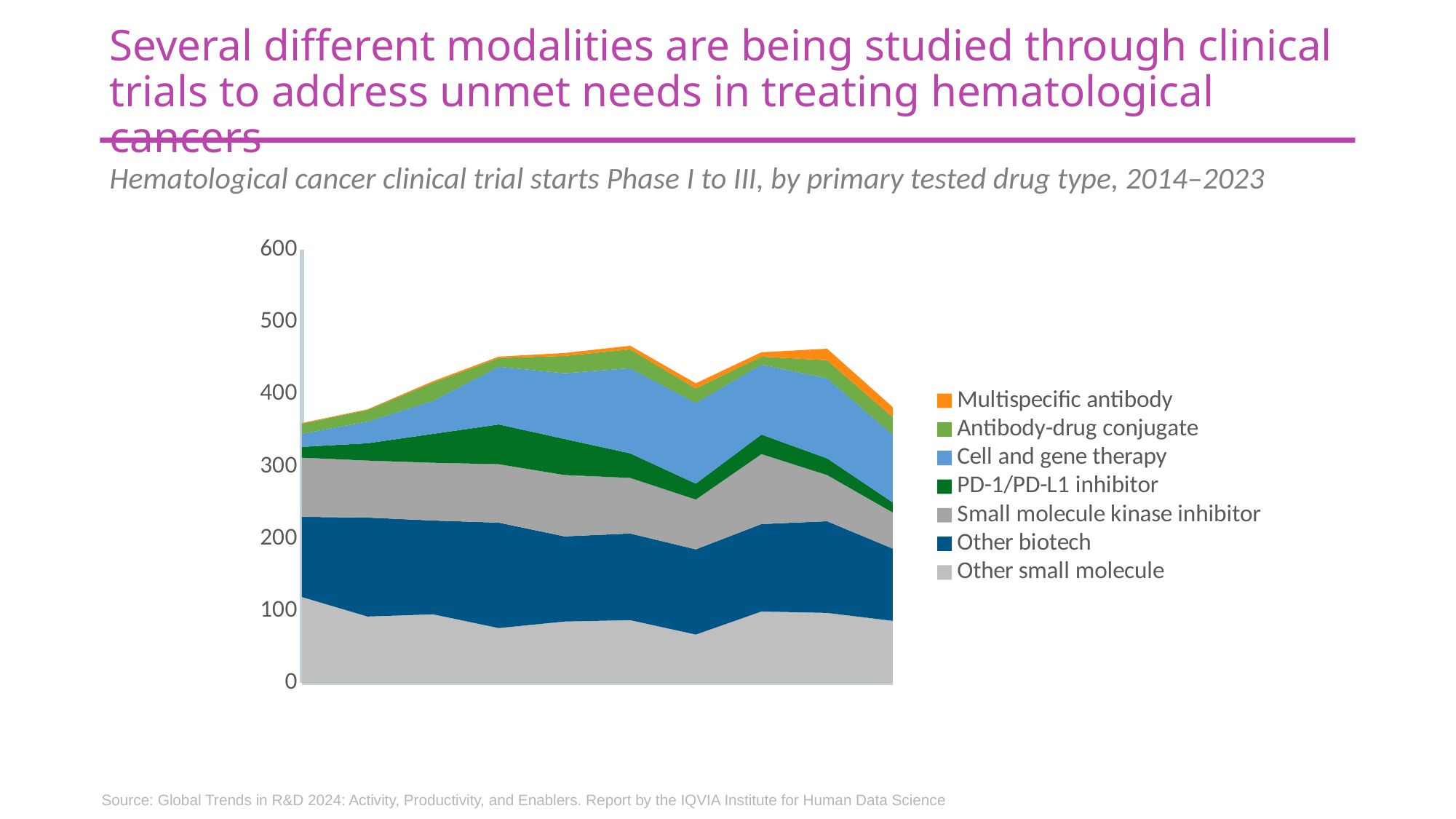
Does the total number of trial starts rise or fall from the leftmost point to the peak in the middle of the chart? rise Which series contributes the smallest area in the chart? Multispecific antibody How many series does the legend list? 7 What kind of chart is shown on the slide? Stacked area chart Is the highest total reached by the stacked areas greater or less than 400? greater Is the total number of trial starts at the leftmost point greater or less than 400? less What is the subtitle describing the chart? Hematological cancer clinical trial starts Phase I to III, by primary tested drug type, 2014–2023 Is the Other small molecule value at the leftmost point greater or less than 100? greater Which series is shown in orange? Multispecific antibody How many yearly data points does the chart cover, according to the subtitle range 2014–2023? 10